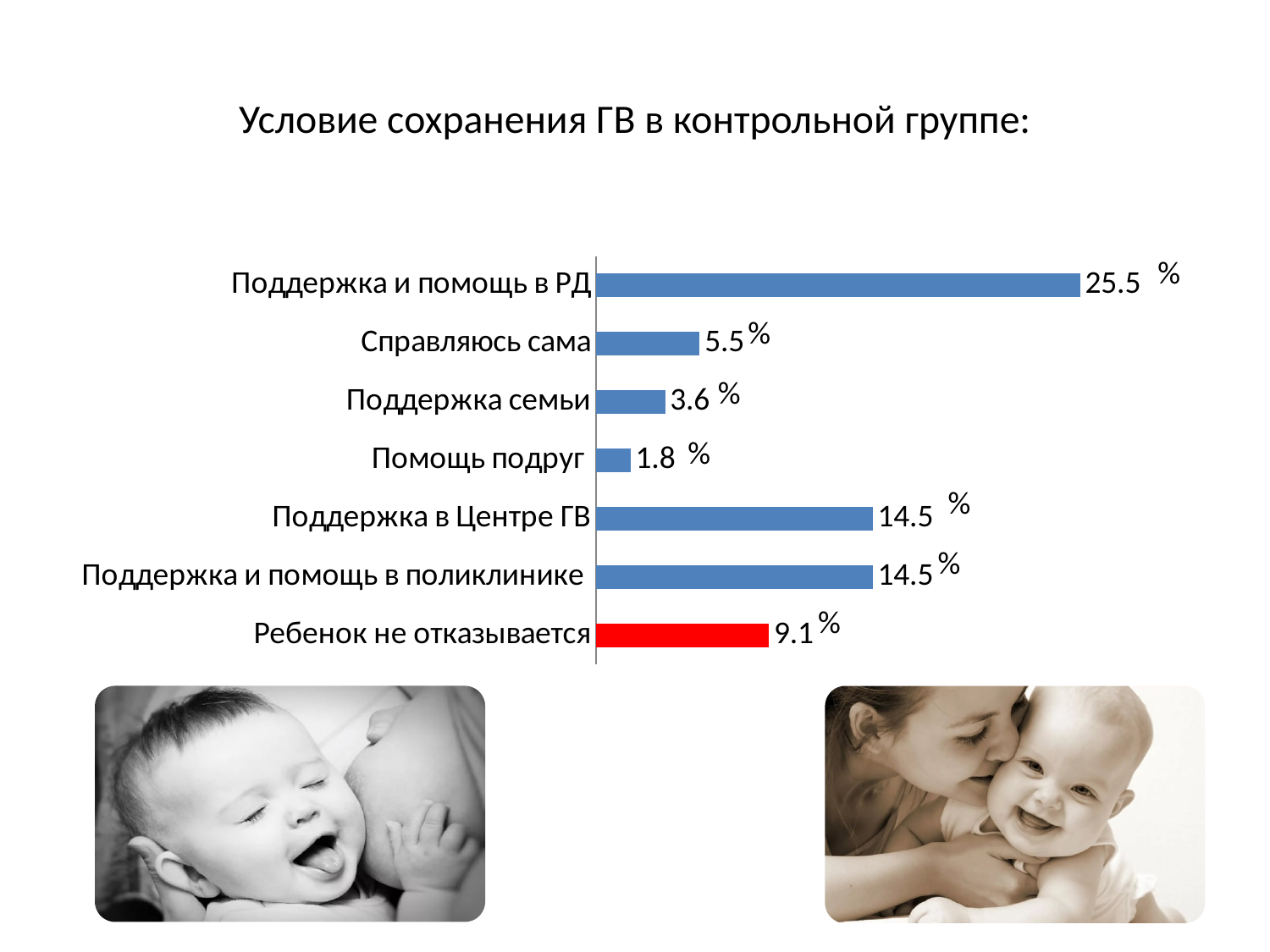
What kind of chart is shown on the slide? Bar chart Which category has the lowest value? Помощь подруг How many categories are shown in the chart? 7 What is the value for «Поддержка и помощь в РД»? 25.5 What is the value for «Справляюсь сама»? 5.5 What is the value for «Помощь подруг»? 1.8 Which category's bar is coloured red? Ребенок не отказывается What is the value for «Ребенок не отказывается»? 9.1 What is the difference between the values for «Справляюсь сама» and «Поддержка семьи»? 1.9 What is the difference between the values for «Поддержка и помощь в РД» and «Поддержка в Центре ГВ»? 11 Which is larger, the value for «Ребенок не отказывается» or the value for «Справляюсь сама»? Ребенок не отказывается Which category has the highest value? Поддержка и помощь в РД